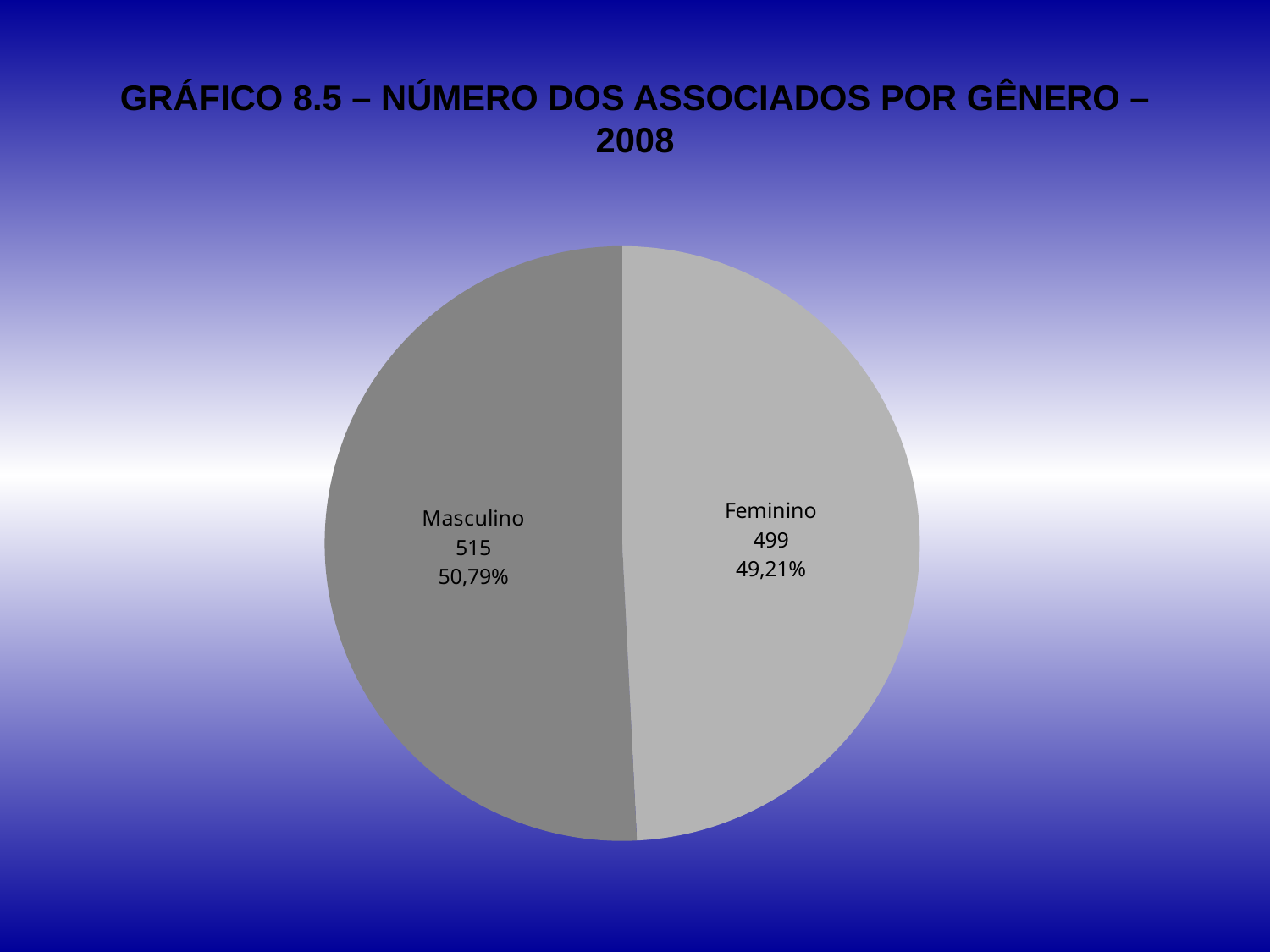
Which category has the larger number of associates? Masculino Which category has the smaller number of associates? Feminino What percentage share does the Masculino slice represent? 50,79% How many slices does the pie chart have? 2 What is the number of associates for Masculino? 515 Which year does the chart refer to? 2008 What is the number of associates for Feminino? 499 What is the total number of associates shown in the pie chart? 1014 What is the difference between the Masculino and Feminino counts? 16 What type of chart is shown on the slide? pie chart What percentage share does the Feminino slice represent? 49,21% What is the title of the chart? GRÁFICO 8.5 – NÚMERO DOS ASSOCIADOS POR GÊNERO – 2008